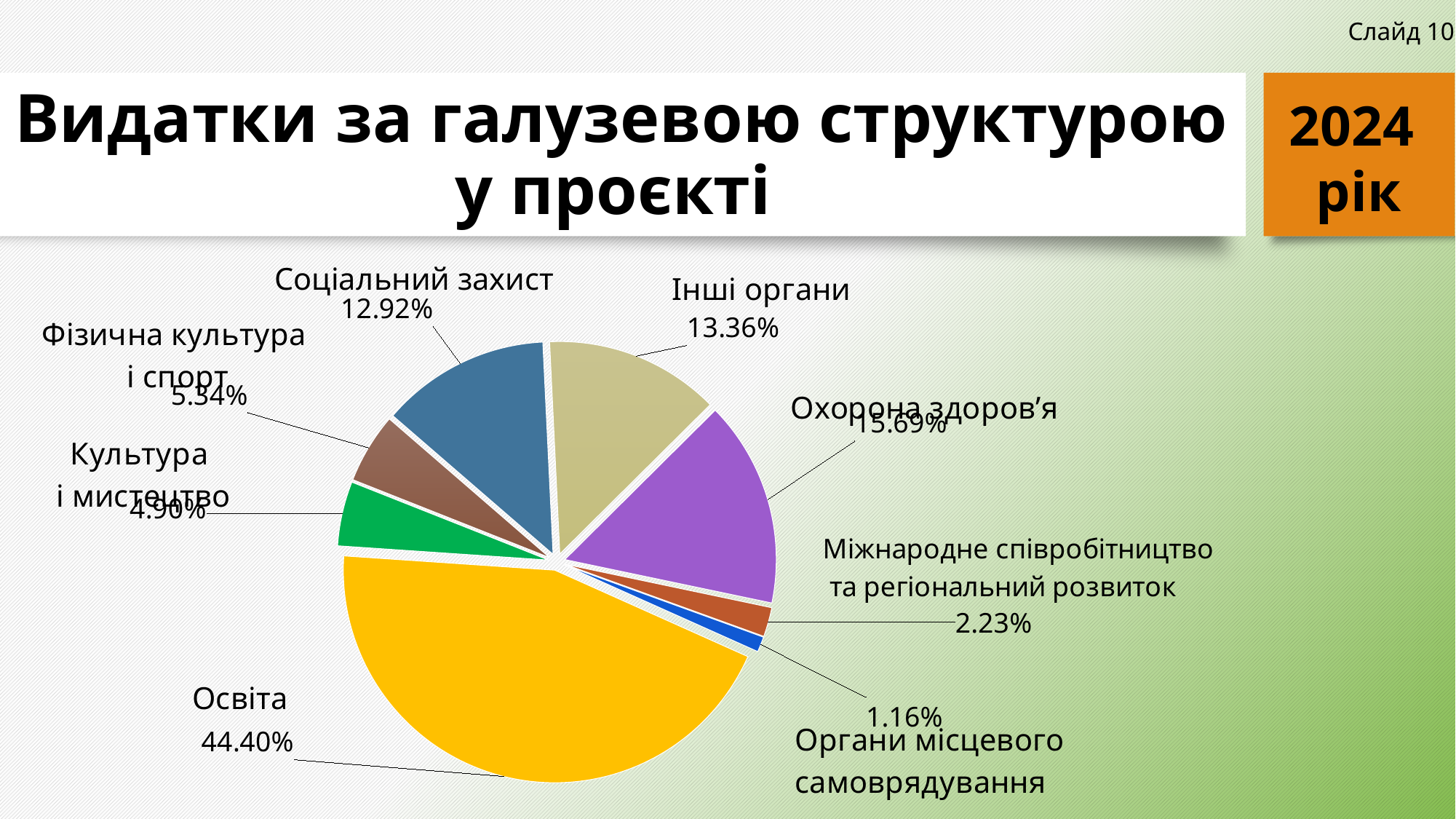
Which category has the largest slice of the pie? Освіта What share of the pie does Освіта account for? 44.40% What is the value shown for Інші органи? 13.36% How many slices does the pie chart have? 8 What is the difference between the shares of Охорона здоров'я and Соціальний захист? 2.77% What share is shown for Міжнародне співробітництво та регіональний розвиток? 2.23% Which is larger, the share for Фізична культура і спорт or the share for Культура і мистецтво? Фізична культура і спорт What type of chart is shown on the slide? Pie chart Which category has the smallest slice of the pie? Органи місцевого самоврядування What is the title of the slide containing the chart? Видатки за галузевою структурою у проєкті What is the value for Охорона здоров'я? 15.69% What percentage is labelled for Соціальний захист? 12.92%